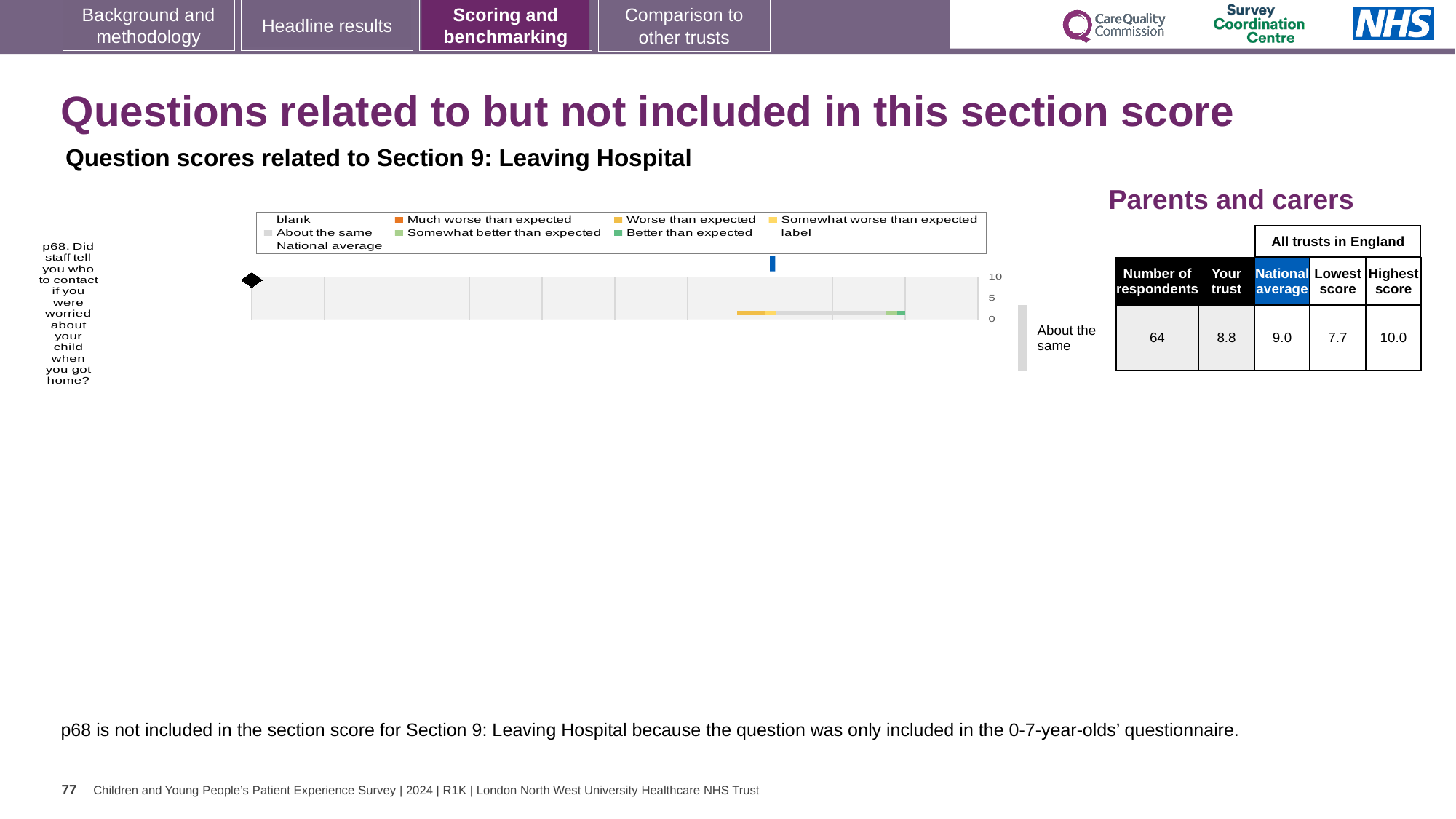
In the table beside the chart, what is the national average score for p68? 9.0 In the table beside the chart, what is the lowest score among all trusts in England for p68? 7.7 What rating label is shown next to the chart for question p68? About the same What kind of chart is shown on the slide? bar chart In the table beside the chart, what is the number of respondents for p68? 64 In the table beside the chart, what is the 'Your trust' score for p68? 8.8 What is the highest value shown on the chart's numeric axis? 10 How many questions (categories) are plotted in the chart? 1 Which question is plotted in the chart? p68. Did staff tell you who to contact if you were worried about your child when you got home? Which is larger for p68: the 'Your trust' score or the national average? national average What is the difference between the highest score and the lowest score for p68 in the table beside the chart? 2.3 In the table beside the chart, what is the highest score among all trusts in England for p68? 10.0